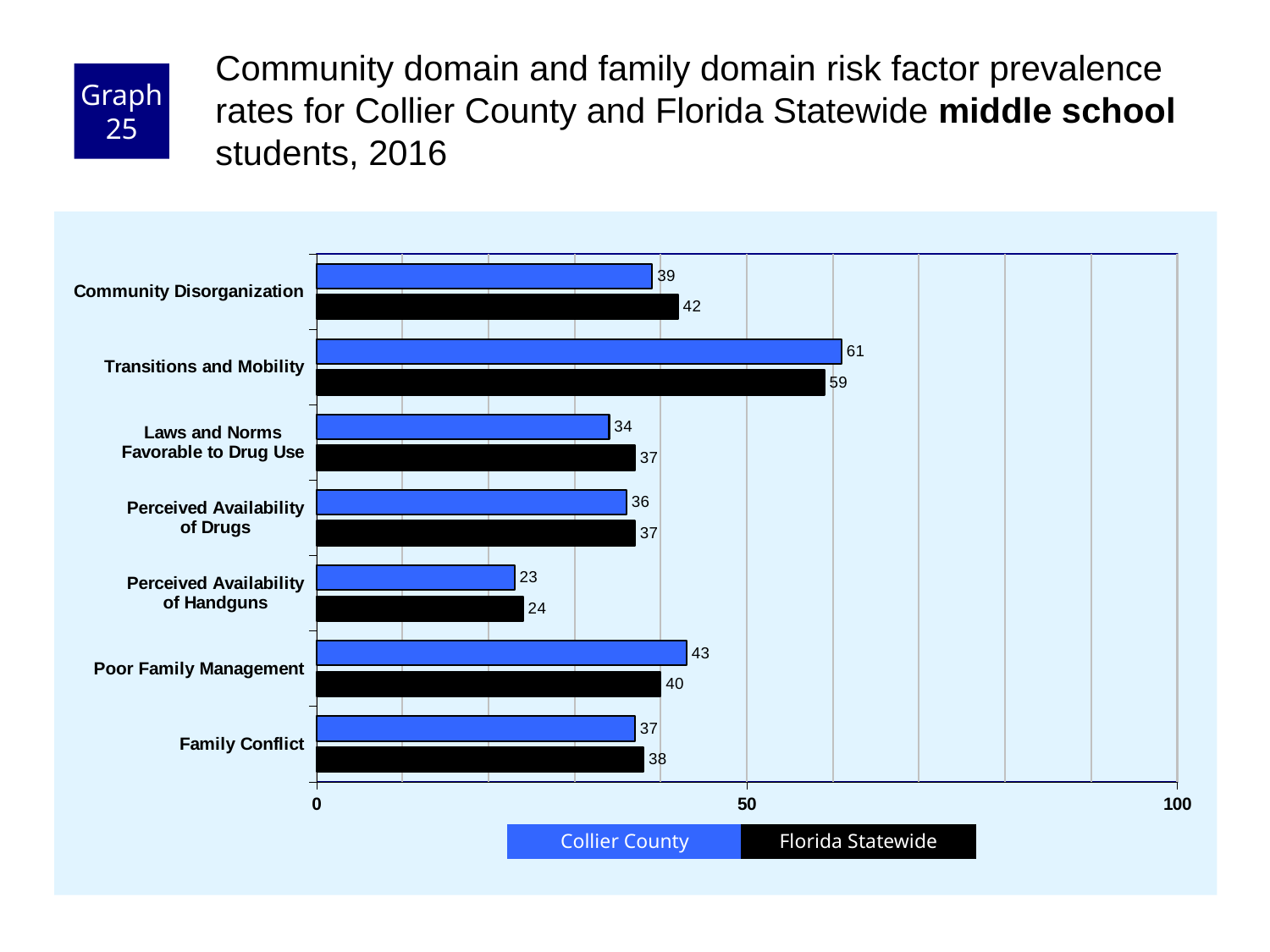
What is the difference between the Florida Statewide and Collier County values for Community Disorganization? 3 What kind of chart is shown on the slide? Bar chart For Laws and Norms Favorable to Drug Use, which is larger: the Collier County value or the Florida Statewide value? Florida Statewide Which risk factor has the lowest Florida Statewide value? Perceived Availability of Handguns Which risk factor has the highest Collier County value? Transitions and Mobility Is the Florida Statewide value for Transitions and Mobility greater or less than 50? greater Which colour represents Florida Statewide in the chart? Black What is the Collier County value for Poor Family Management? 43 What is the Collier County value for Transitions and Mobility? 61 How many series does the legend list? 2 How many risk factor categories are shown on the chart? 7 What is the Florida Statewide value for Perceived Availability of Handguns? 24